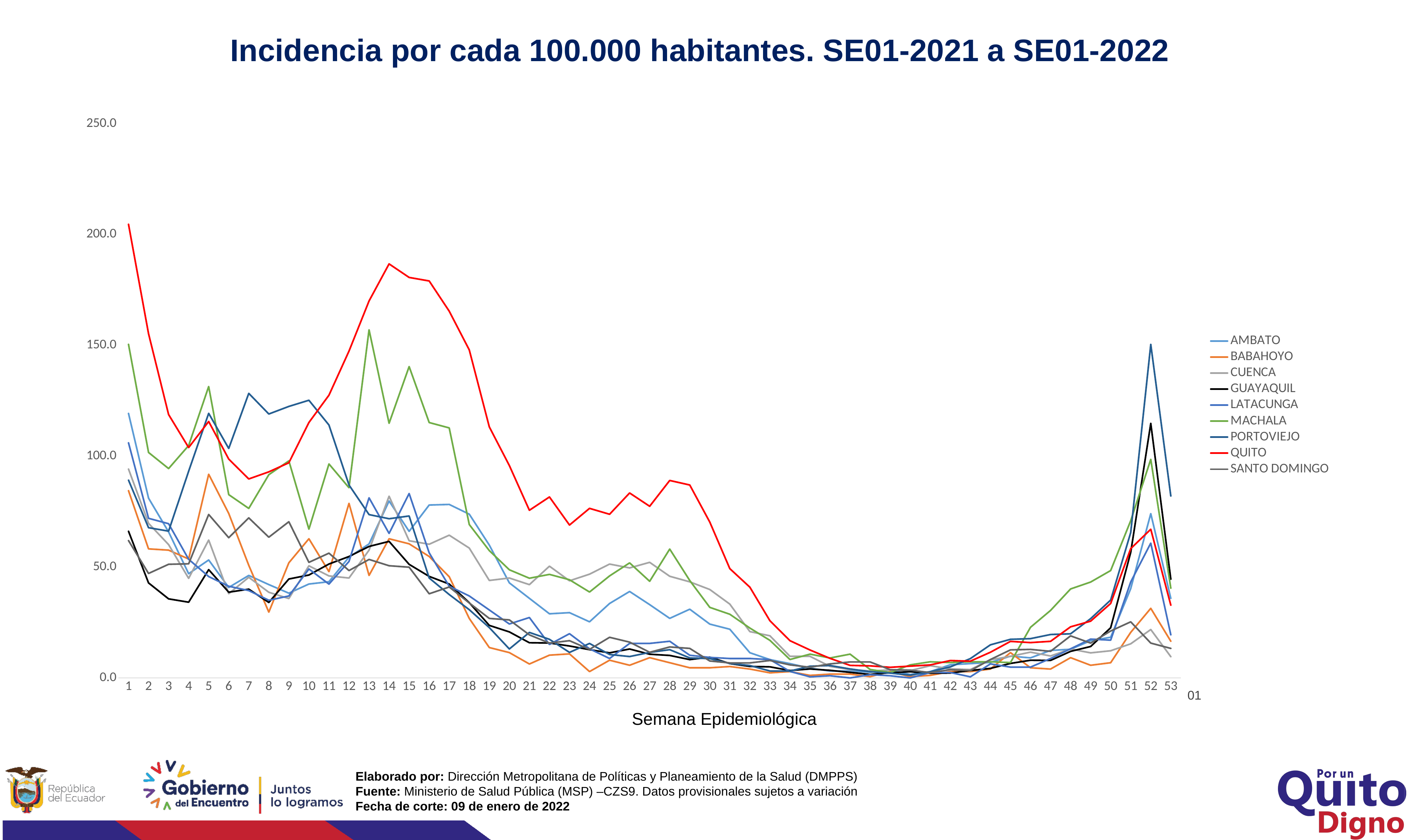
At week 52, which is larger: the value for PORTOVIEJO or the value for QUITO? PORTOVIEJO How many series does the legend list? 9 Is the value for QUITO at week 39 greater or less than 50? less What is the x-axis title of the chart? Semana Epidemiológica Is the value for QUITO at week 1 greater or less than 150? greater Which series has the highest value at week 14? QUITO Is the value for PORTOVIEJO at week 52 greater or less than 100? greater What kind of chart is shown on the slide? line chart Which series has the highest value at week 1? QUITO What is the title of the chart? Incidencia por cada 100.000 habitantes. SE01-2021 a SE01-2022 Does the QUITO series rise or fall from week 14 to week 39? fall Which series has the highest value at week 52? PORTOVIEJO